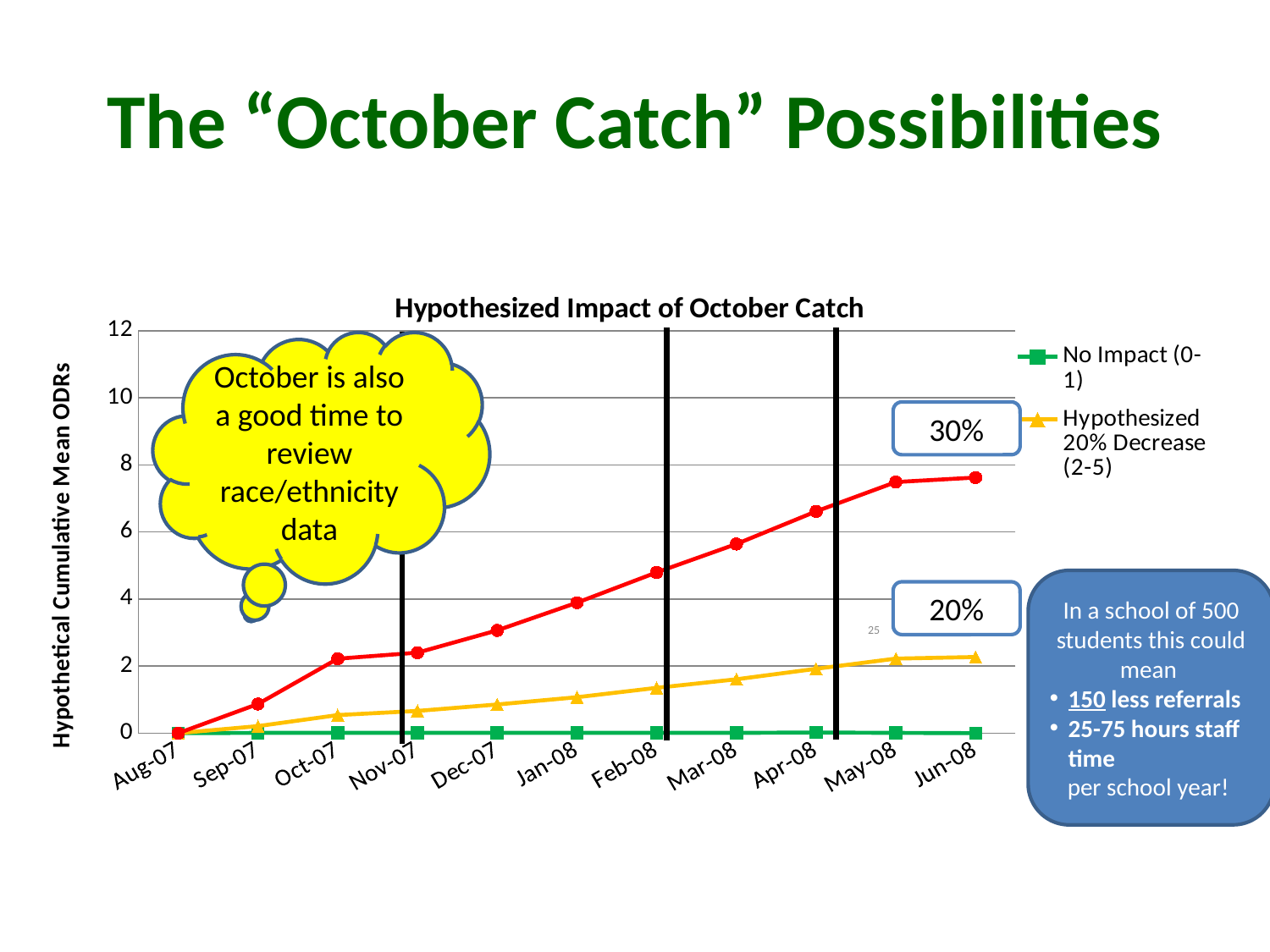
Is the value of the Hypothesized 20% Decrease (2-5) line at Mar-08 greater or less than 2? less At May-08, which is higher: the No Impact (0-1) line or the Hypothesized 20% Decrease (2-5) line? Hypothesized 20% Decrease (2-5) Is the value of the red line at Dec-07 greater or less than 4? less How many series does the chart's legend list? 2 At Jun-08, which is higher: the red line or the Hypothesized 20% Decrease (2-5) line? the red line Does the red line rise or fall from Aug-07 to Jun-08? rise What is the title of the chart? Hypothesized Impact of October Catch How many months are shown along the x axis of the chart? 11 What type of chart is shown on the slide? line chart Is the value of the red line at Feb-08 greater or less than 4? greater What is the label on the vertical axis of the chart? Hypothetical Cumulative Mean ODRs